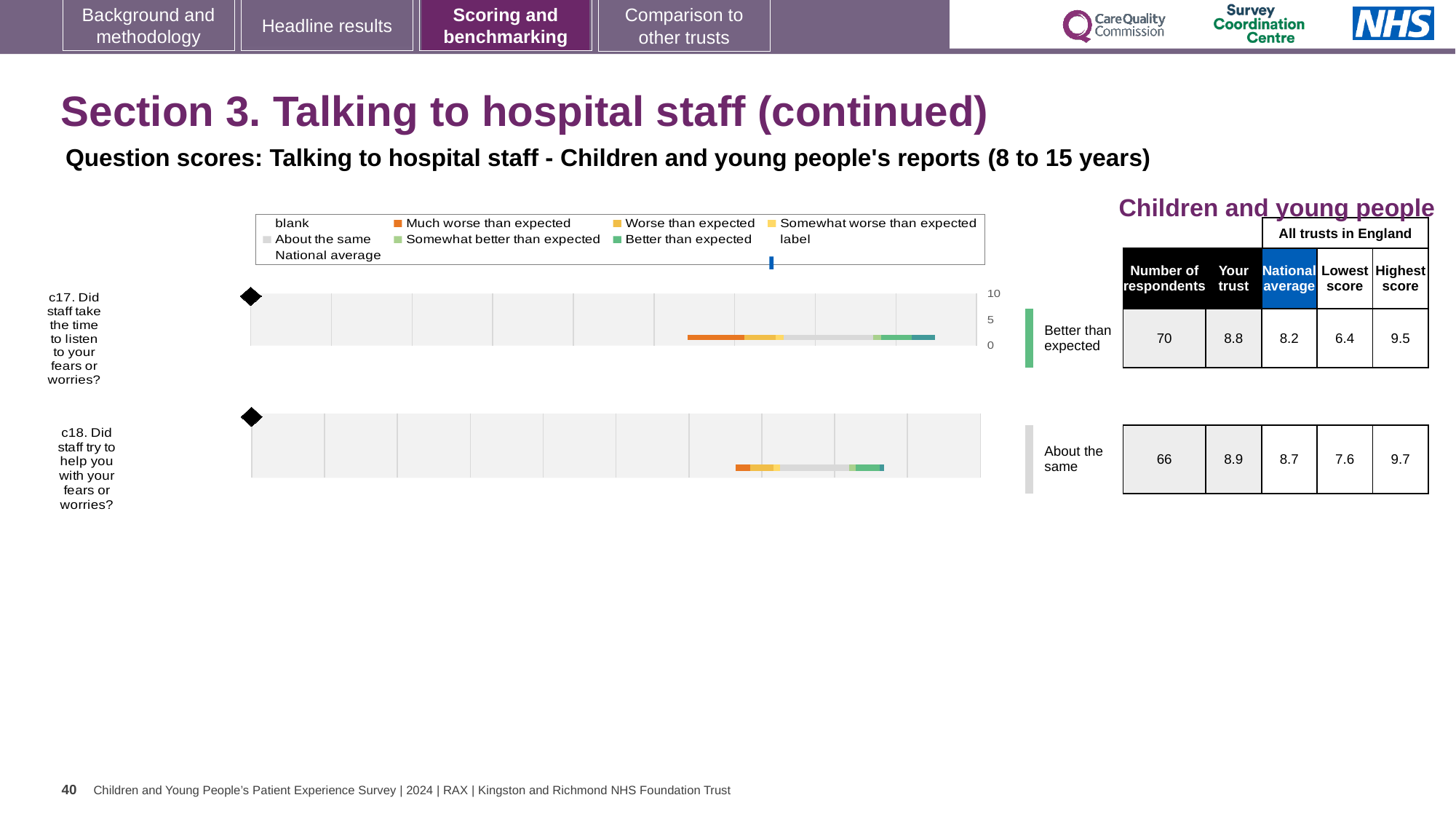
What benchmark category is c17 assigned to? Better than expected What benchmark category is c18 assigned to? About the same By how much does the trust's score for c17 exceed the national average? 0.6 What is the lowest score among all trusts in England for c17? 6.4 What is the difference between the highest and lowest scores for c18? 2.1 What is the highest score among all trusts in England for c18? 9.7 What is the 'Your trust' score for c17 (Did staff take the time to listen to your fears or worries?)? 8.8 What kind of chart is used to show the question scores for c17 and c18? bar chart What is the national average score for c18 (Did staff try to help you with your fears or worries?)? 8.7 How many respondents answered c17? 70 How many survey questions are plotted on the chart? 2 Which question had more respondents, c17 or c18? c17